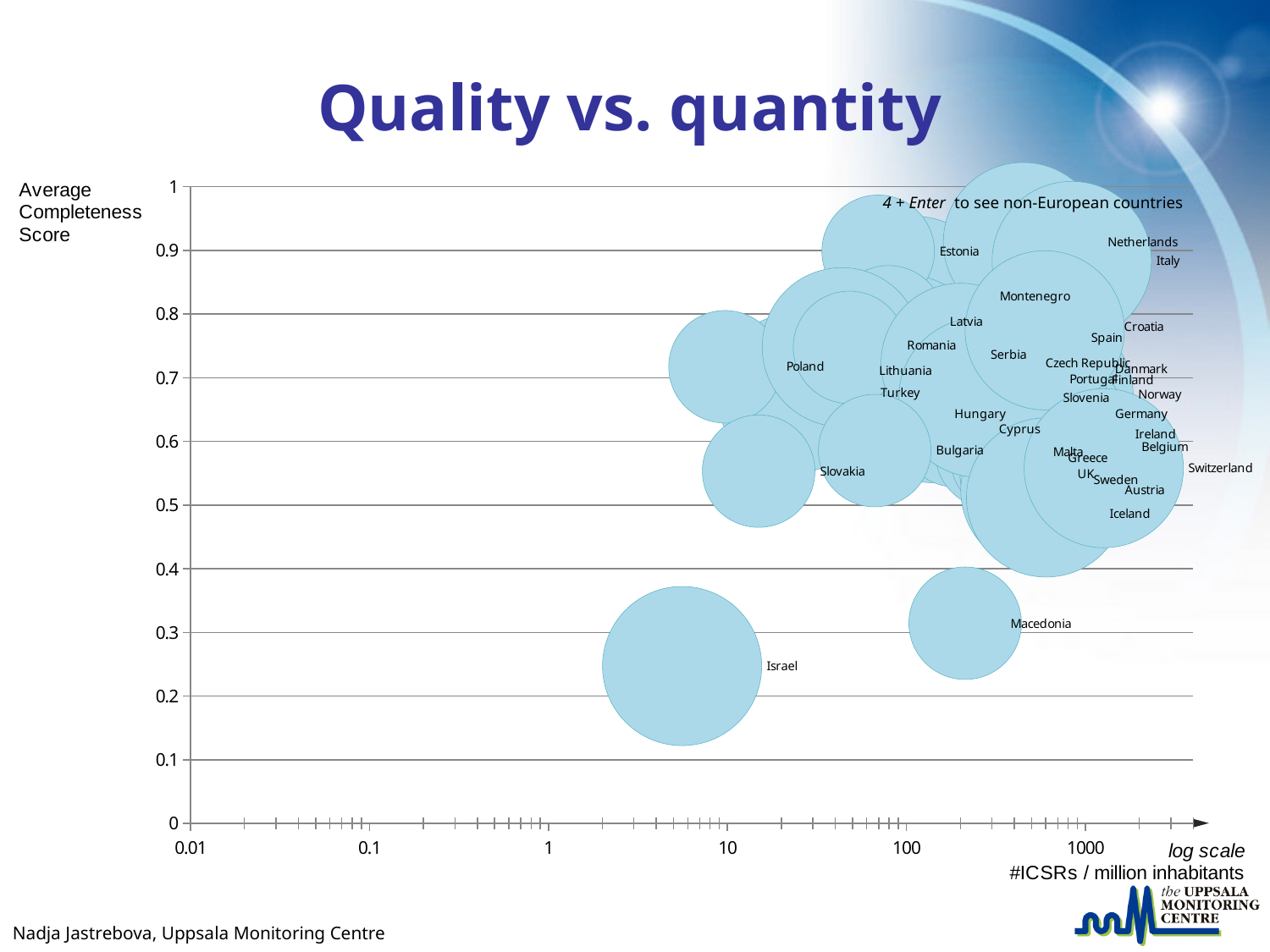
Is the Average Completeness Score for Macedonia greater or less than 0.4? less Is the number of ICSRs per million inhabitants for Israel greater or less than 10? less Is the number of ICSRs per million inhabitants for Macedonia greater or less than 100? greater Which country has the lowest Average Completeness Score in the chart? Israel What is the title of the chart? Quality vs. quantity Which has the higher Average Completeness Score, Israel or Poland? Poland What kind of chart is shown on the slide? bubble chart Which has the higher Average Completeness Score, Israel or Macedonia? Macedonia What quantity is plotted on the horizontal axis of the chart? #ICSRs / million inhabitants